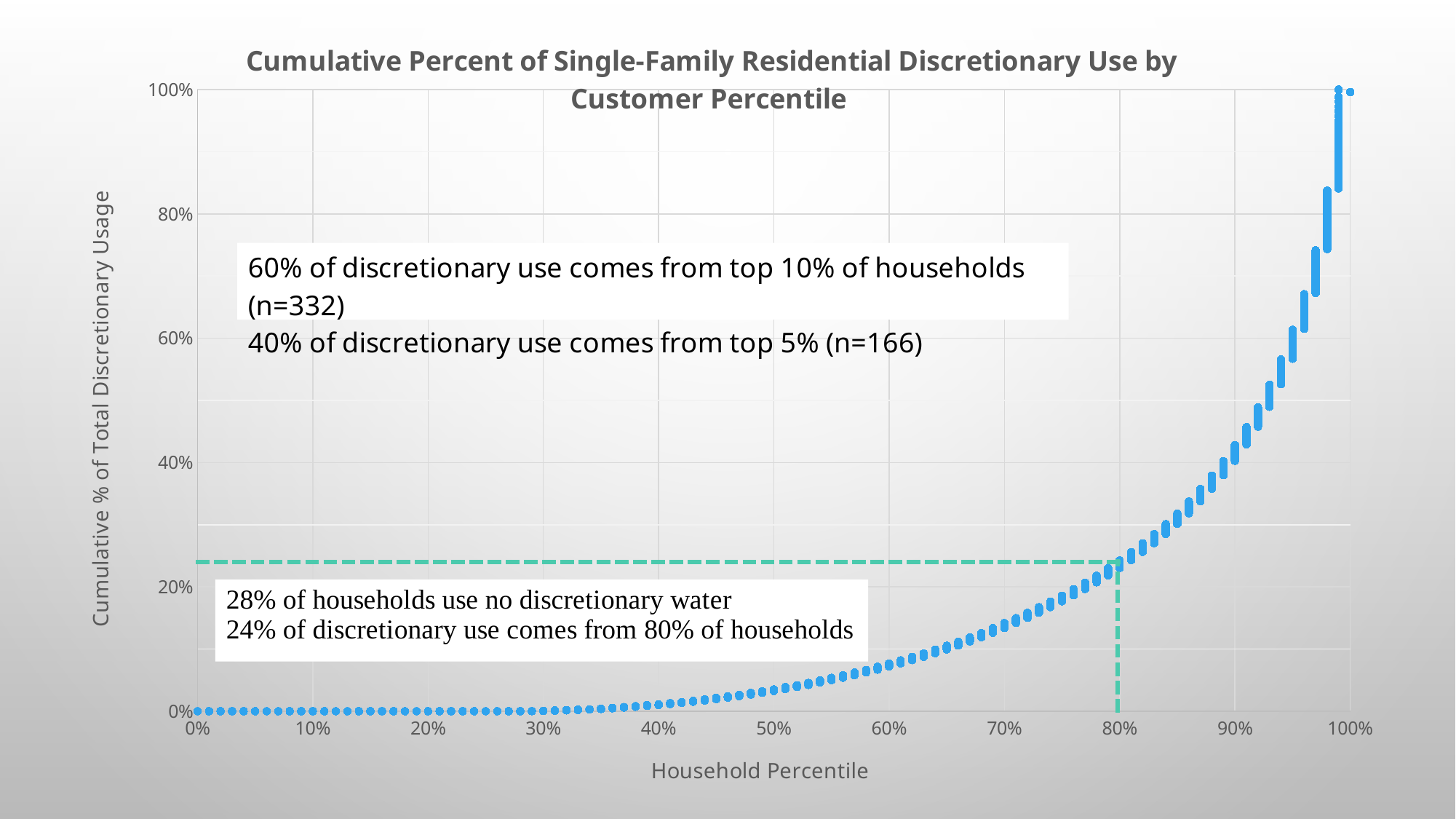
Is the cumulative value at the 50% household percentile greater or less than 20%? less What is the difference between the share of discretionary use from the top 10% of households and the share from the top 5%? 20% What percent of households use no discretionary water, according to the slide? 28% What kind of chart is shown on the slide? Scatter chart Is the cumulative value at the 85% household percentile greater or less than 20%? greater Do the plotted values rise or fall as the household percentile increases? Rise According to the slide, what cumulative percent of discretionary use comes from 80% of households? 24% According to the slide, what percent of discretionary use comes from the top 10% of households? 60% What is the label of the x axis? Household Percentile Is the cumulative value at the 70% household percentile greater or less than 20%? less According to the slide, what percent of discretionary use comes from the top 5% of households? 40% What is the title of the chart? Cumulative Percent of Single-Family Residential Discretionary Use by Customer Percentile